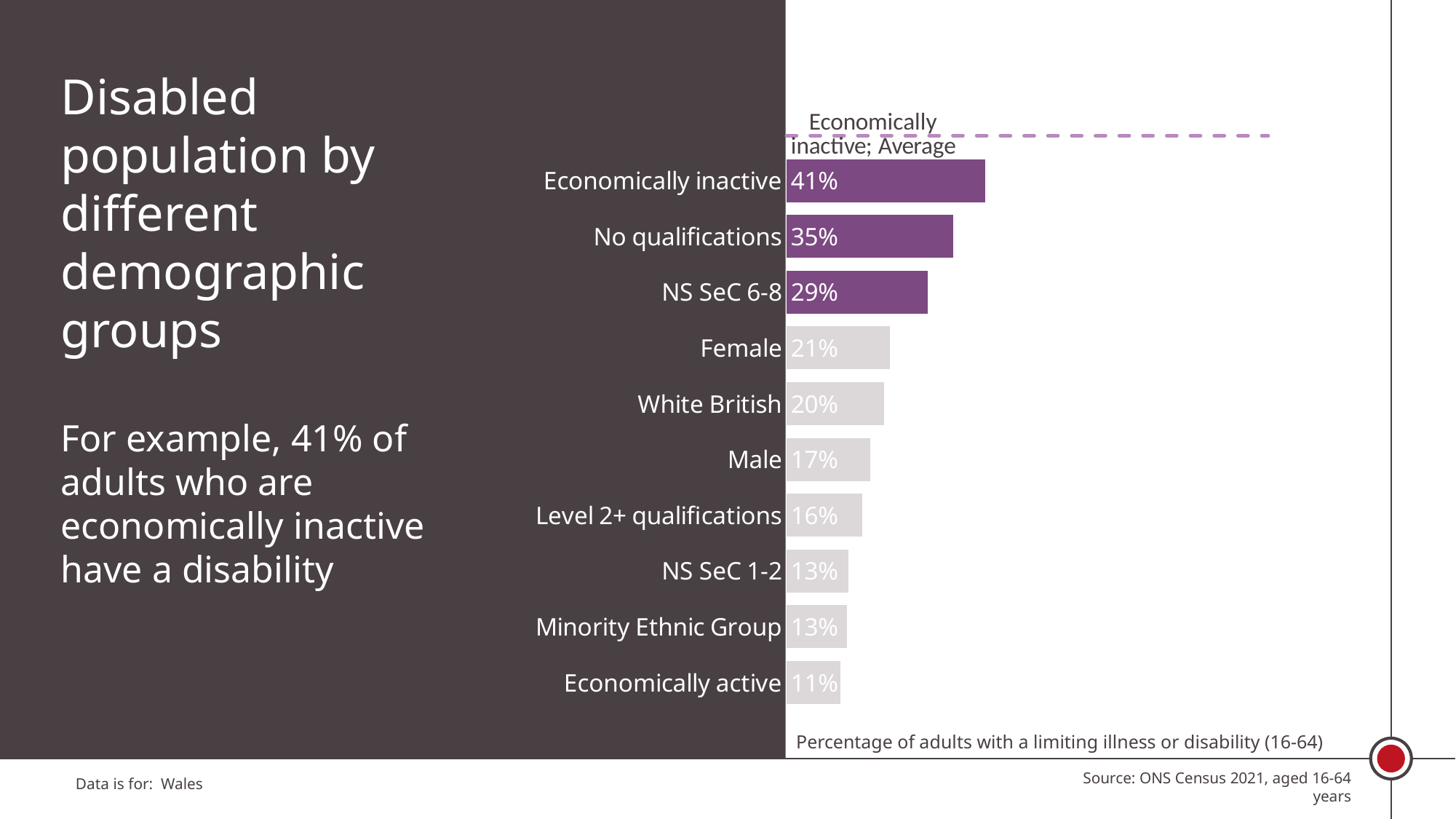
What is the difference in percentage points between No qualifications and Level 2+ qualifications? 19 What is the value shown for the Female category? 21% Which category has the lowest percentage of adults with a limiting illness or disability? Economically active What is the value shown for NS SeC 1-2? 13% Which category has the highest percentage of adults with a limiting illness or disability? Economically inactive What is the difference in percentage points between Economically inactive and Economically active? 30 What type of chart is shown on the slide? Bar chart How many demographic categories are shown in the bar chart? 10 What percentage of economically inactive adults have a limiting illness or disability? 41% Which has a higher value, Female or Male? Female What does the dashed line at the top of the chart represent? Economically inactive; Average Which has a higher value, NS SeC 6-8 or White British? NS SeC 6-8